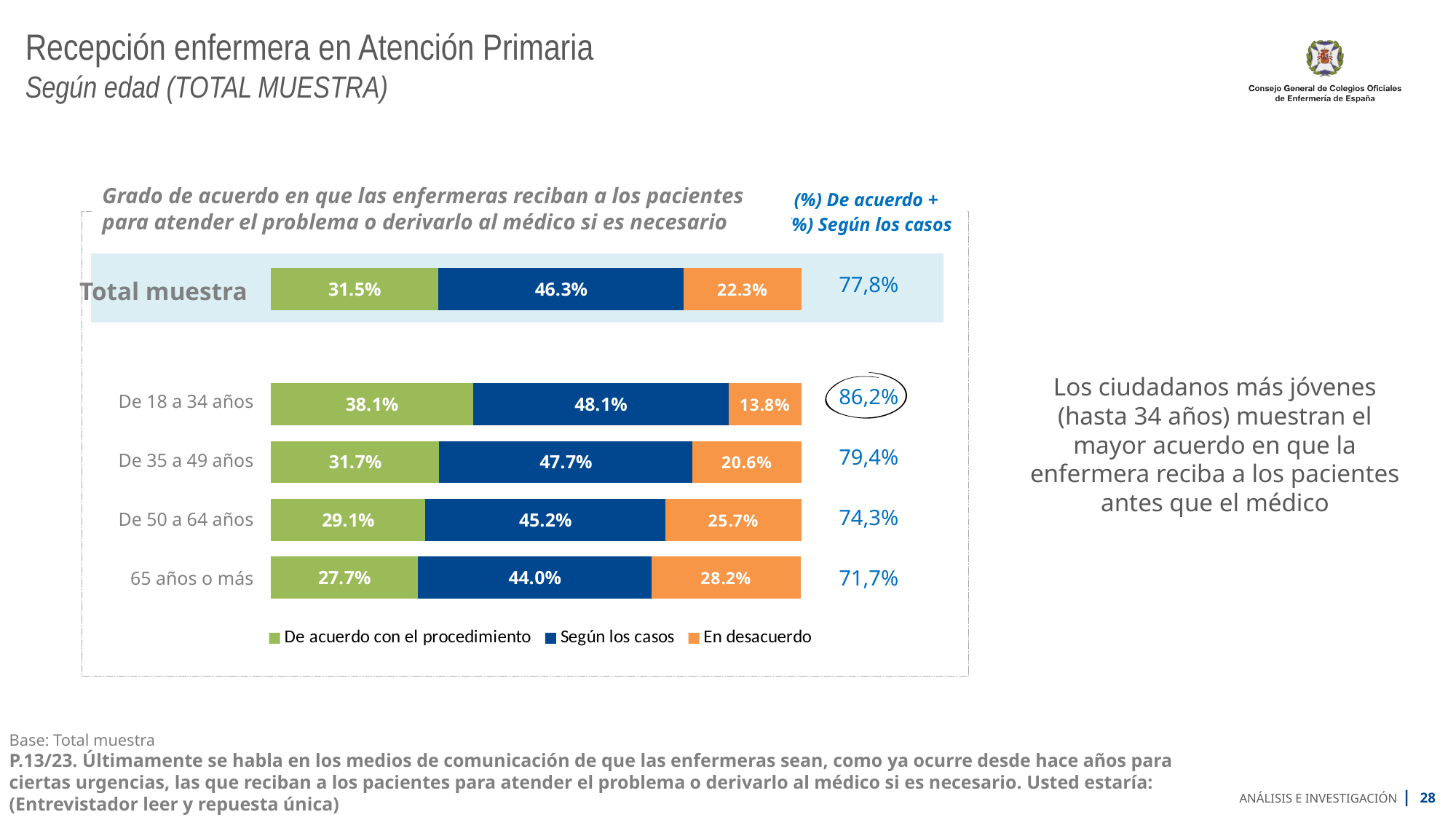
Which colour represents 'En desacuerdo' in the chart? Orange What is the 'En desacuerdo' value for the '65 años o más' group? 28.2% What is the 'Según los casos' value for 'Total muestra'? 46.3% What is the difference between the 'En desacuerdo' values for 'De 50 a 64 años' and 'De 18 a 34 años'? 11.9 percentage points What percentage of the 'De 18 a 34 años' group is 'De acuerdo con el procedimiento'? 38.1% How many age groups (excluding 'Total muestra') are shown in the chart? 4 What is the combined '(%) De acuerdo + (%) Según los casos' value shown for 'De 18 a 34 años'? 86,2% What type of chart is shown on the slide? Stacked bar chart Which age group has the highest 'En desacuerdo' percentage? 65 años o más How many series does the legend list? 3 Which age group has the lowest 'De acuerdo con el procedimiento' percentage? 65 años o más Which is larger: the 'Según los casos' value for 'De 35 a 49 años' or for '65 años o más'? De 35 a 49 años